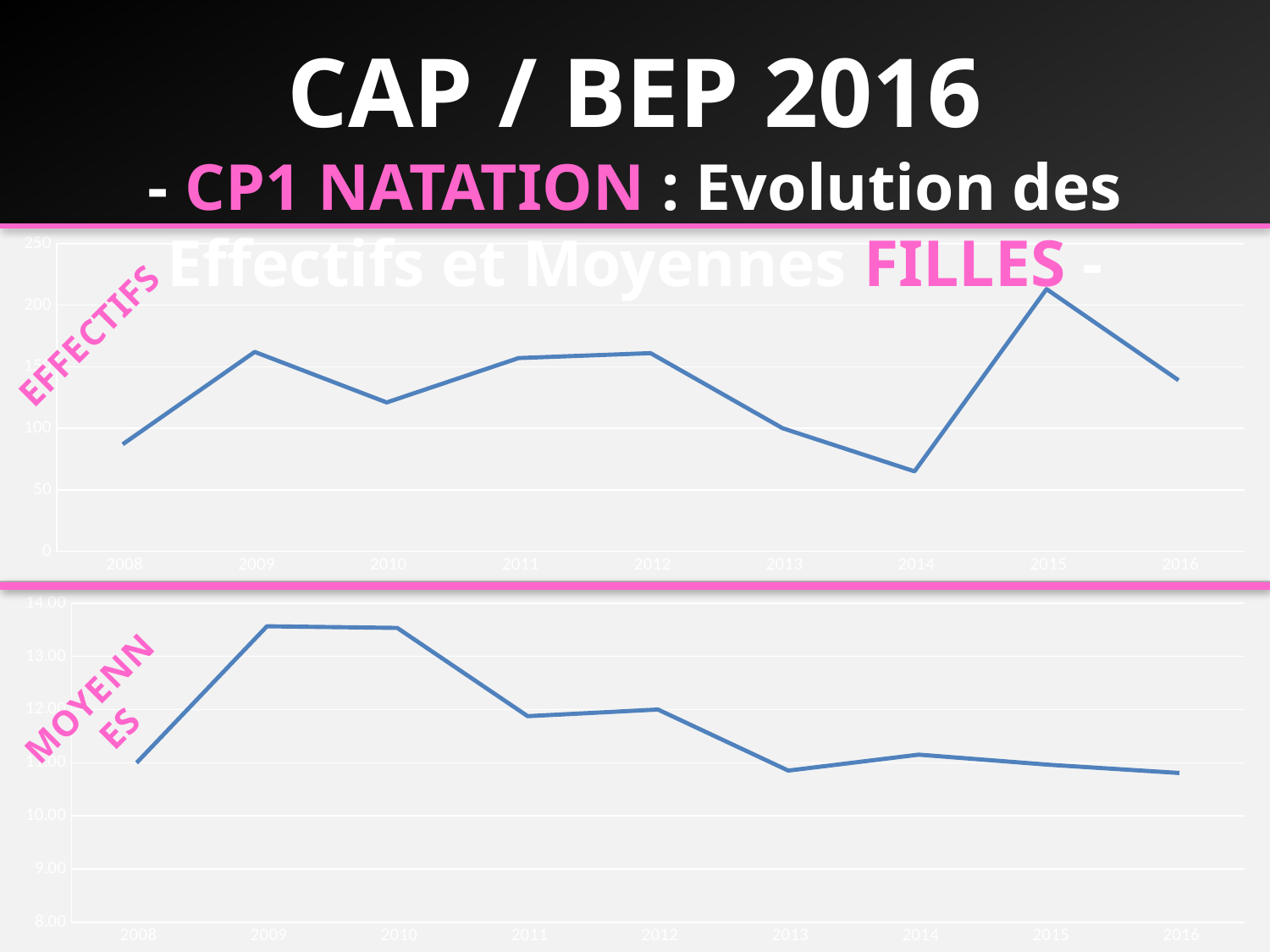
What kind of chart is the top chart (EFFECTIFS)? line chart In the bottom chart (MOYENNES), is the value for 2009 greater or less than 13.00? greater In the bottom chart (MOYENNES), which is larger, the value for 2008 or the value for 2009? 2009 In the top chart (EFFECTIFS), is the value for 2009 greater or less than 150? greater In the top chart (EFFECTIFS), which year has the highest value? 2015 In the bottom chart (MOYENNES), does the line rise or fall from 2010 to 2011? fall How many years are plotted on the x axis of the bottom chart (MOYENNES)? 9 In the top chart (EFFECTIFS), is the value for 2015 greater or less than 200? greater In the top chart (EFFECTIFS), which year has the lowest value? 2014 In the top chart (EFFECTIFS), which is larger, the value for 2015 or the value for 2016? 2015